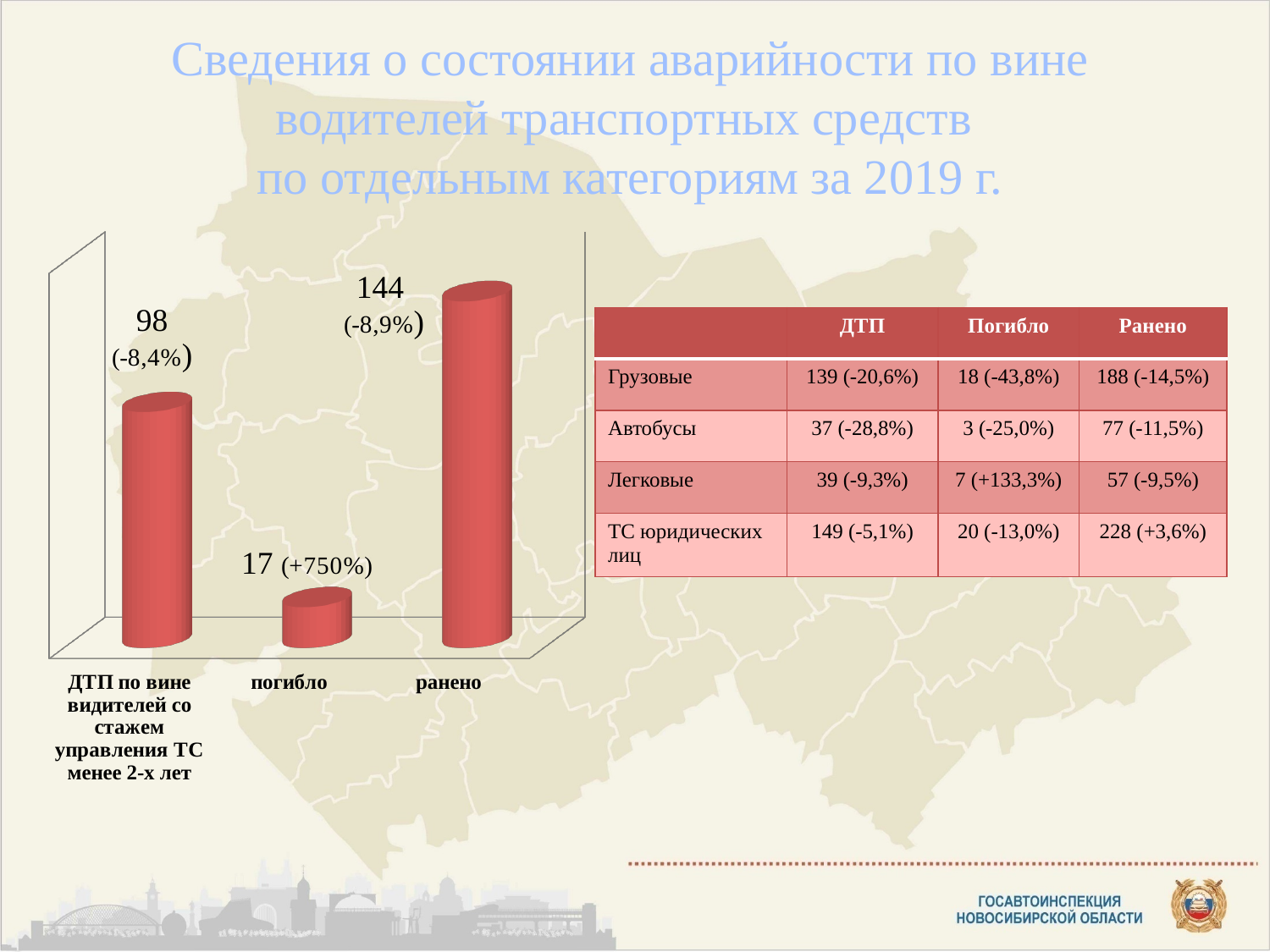
What type of chart is shown on the slide? bar chart What is the value of the bar for "погибло"? 17 What is the value of the bar for "ДТП по вине водителей со стажем управления ТС менее 2-х лет"? 98 What is the value of the bar for "ранено"? 144 What is the difference between the values for "ранено" and "ДТП по вине водителей со стажем управления ТС менее 2-х лет"? 46 How many categories does the bar chart show? 3 Which is larger, the value for "погибло" or the value for "ранено"? ранено What percentage change is shown next to the "ранено" bar? -8,9% What is the difference between the values for "ранено" and "погибло"? 127 Which category has the highest bar in the chart? ранено What percentage change is shown next to the "погибло" bar? +750% Which category has the lowest bar in the chart? погибло